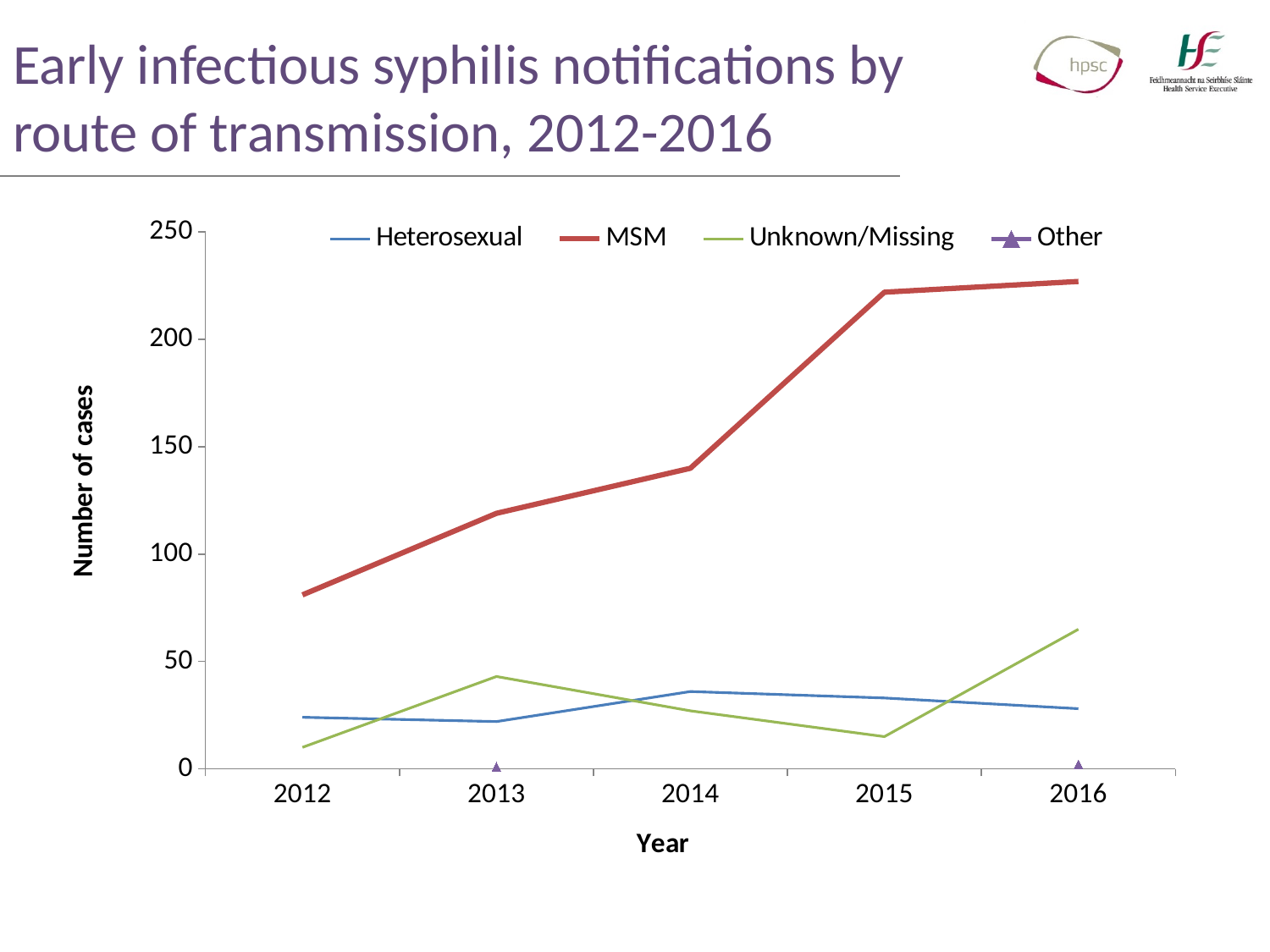
What is the title of the y axis? Number of cases Which route of transmission has the highest number of cases in 2016? MSM Does the MSM line rise or fall from 2012 to 2016? rise In 2015, which is larger: Heterosexual or Unknown/Missing? Heterosexual How many series does the legend list? 4 What kind of chart is shown on the slide? line chart In 2013, which is larger: Heterosexual or Unknown/Missing? Unknown/Missing How many years are shown on the x axis? 5 Is the value for MSM in 2015 greater or less than 200? greater Is the value for MSM in 2012 greater or less than 100? less Is the value for Unknown/Missing in 2016 greater or less than 50? greater In which year is the MSM value lowest? 2012